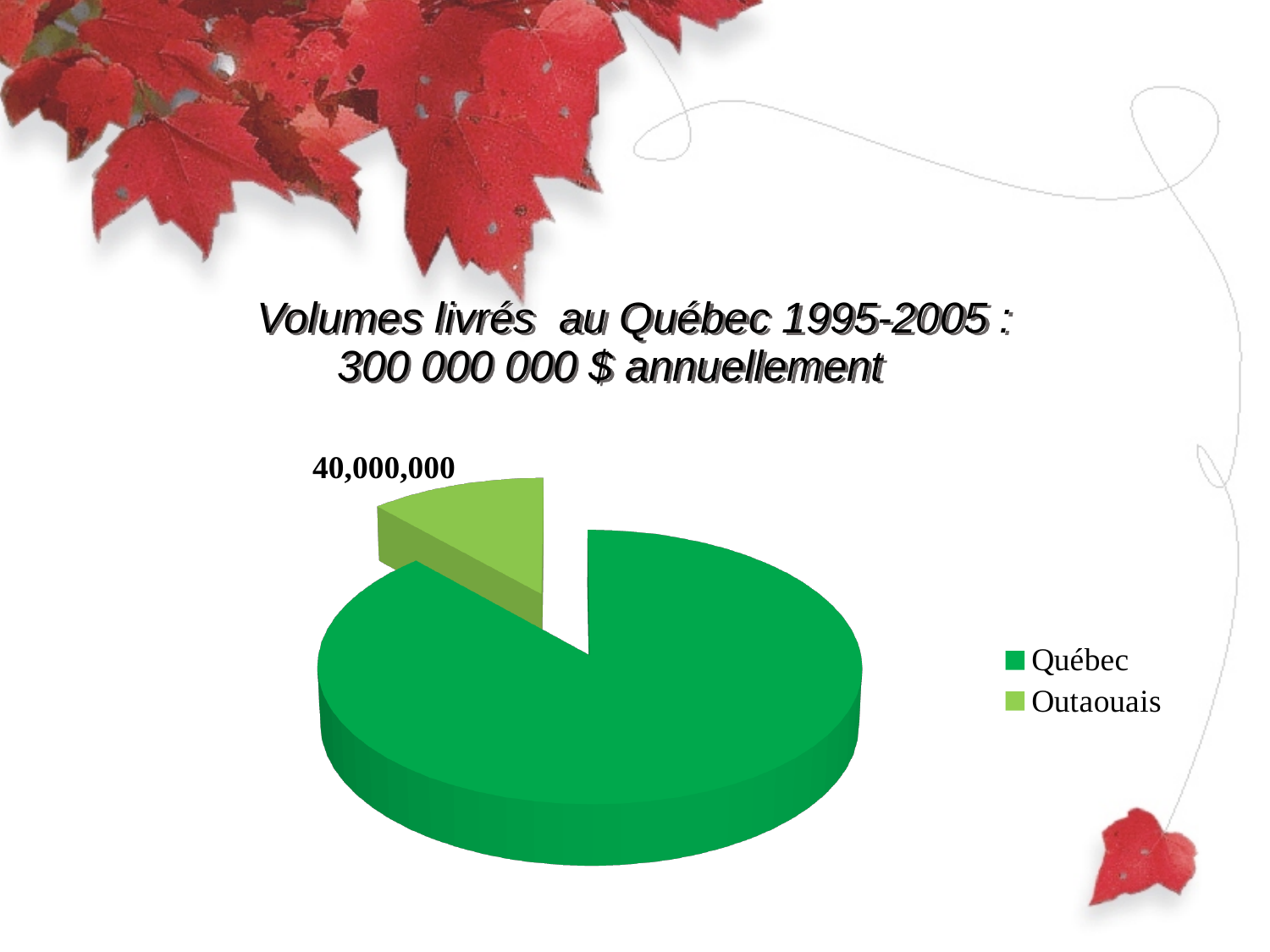
How many entries does the legend of the pie chart list? 2 Which slice is larger in the pie chart, Québec or Outaouais? Québec Which category has the largest slice in the pie chart? Québec Which category is shown in the lighter green colour in the pie chart? Outaouais Which category has the smallest slice in the pie chart? Outaouais What value is labelled on the Outaouais slice of the pie chart? 40,000,000 What are the two categories listed in the legend of the pie chart? Québec and Outaouais How many slices does the pie chart have? 2 What kind of chart is shown on the slide? Pie chart